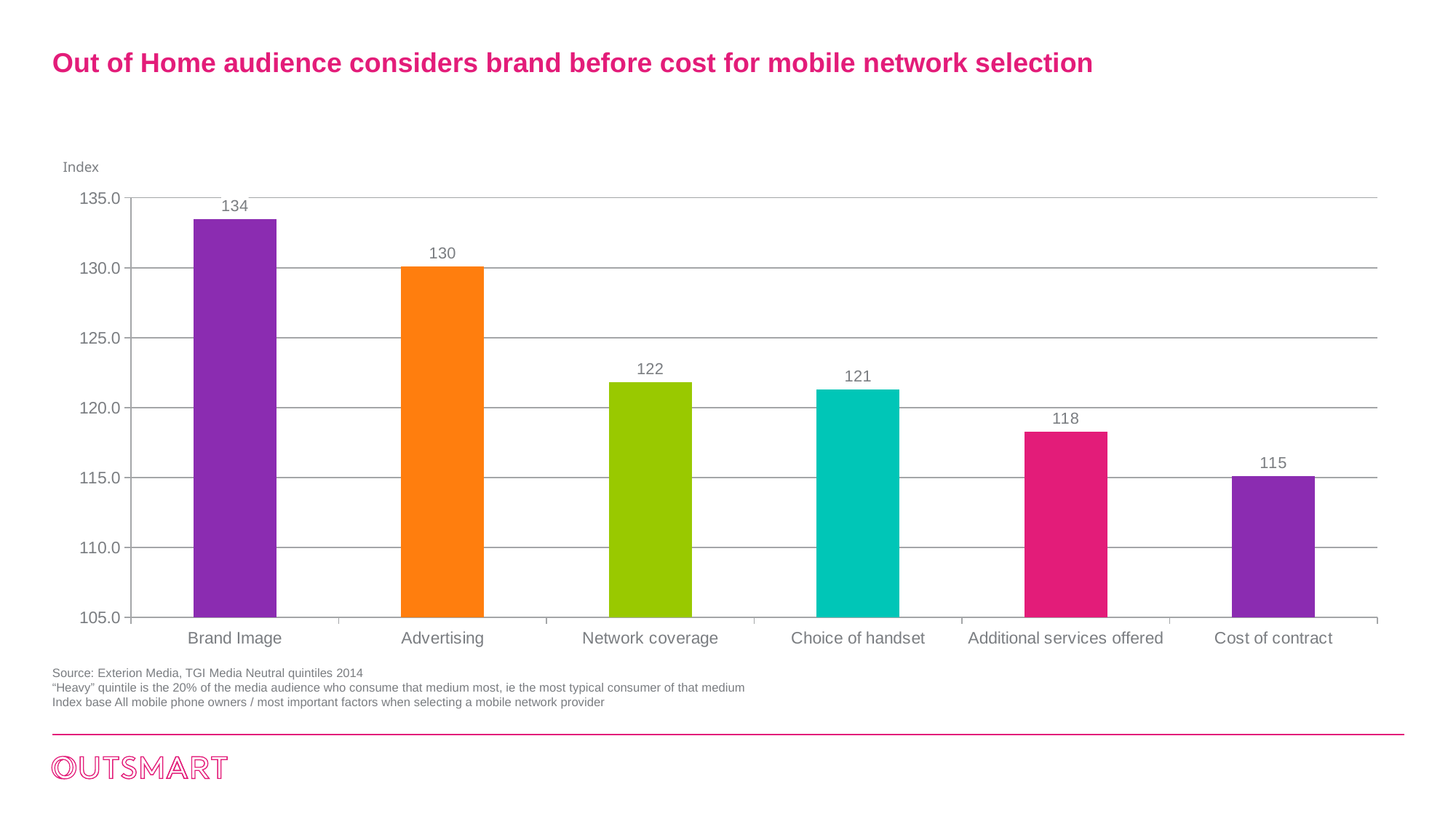
What is the difference between the index values for Advertising and Additional services offered? 12 How many categories are shown on the chart? 6 What is the difference between the index values for Brand Image and Cost of contract? 19 Which category has the lowest index value? Cost of contract Do the values rise or fall from left to right along the x axis? Fall What is the index value for Cost of contract? 115 Is the value for Additional services offered greater or less than 120? less What is the index value for Brand Image? 134 What is the index value for Network coverage? 122 What kind of chart is shown on the slide? Bar chart Which category has the highest index value? Brand Image Which has a higher index value, Advertising or Choice of handset? Advertising